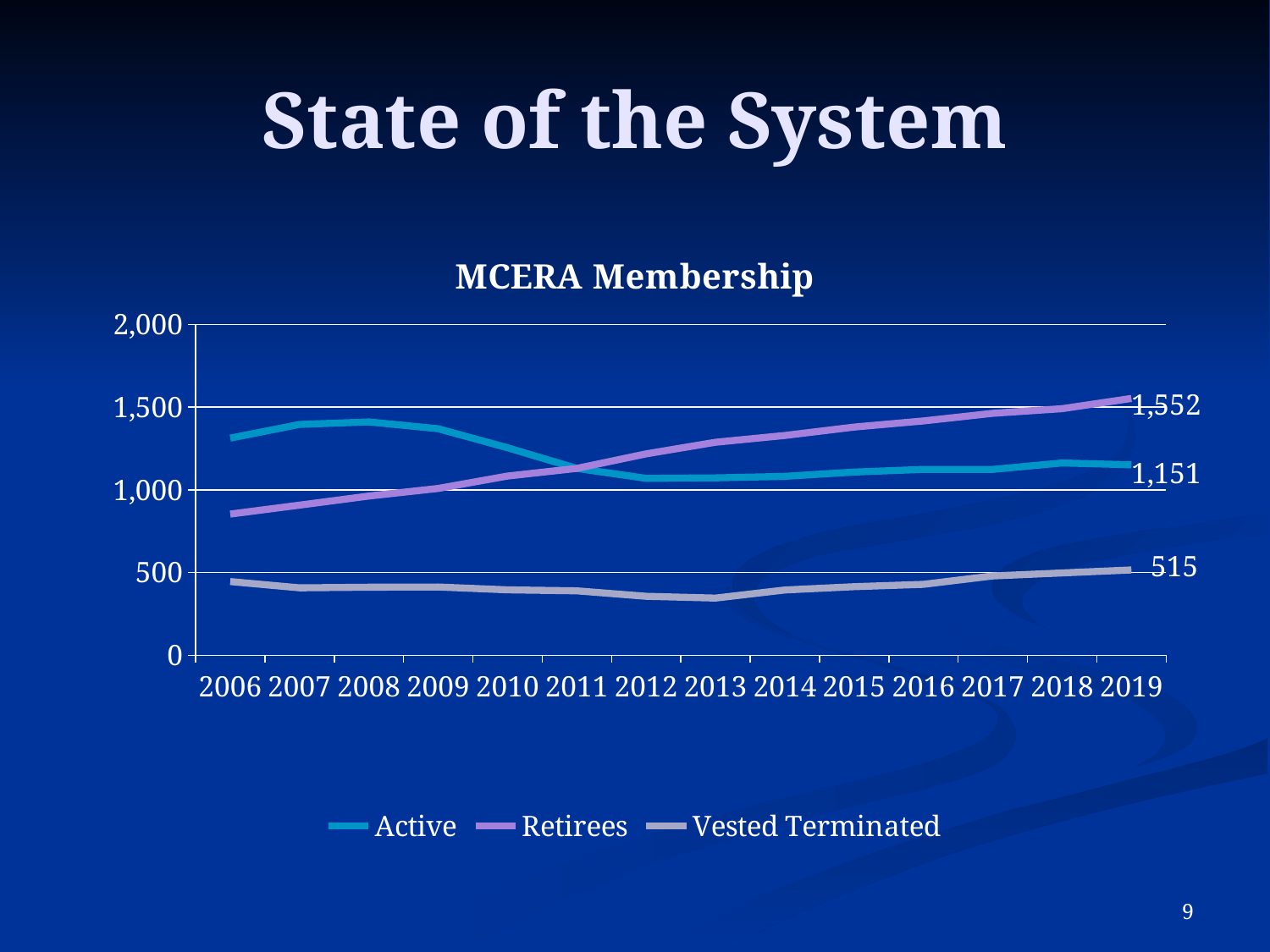
What is the value for Retirees in 2019? 1,552 Does the Retirees line rise or fall from 2006 to 2019? Rises How many years are shown on the x axis of the MCERA Membership chart? 14 How many series does the legend of the MCERA Membership chart list? 3 What is the value for Active in 2019? 1,151 What is the title of the chart? MCERA Membership Which series has the highest value in 2019? Retirees What kind of chart is shown on the slide? Line chart What is the value for Vested Terminated in 2019? 515 Which series has the lowest value in 2019? Vested Terminated Is the value for Retirees in 2006 greater or less than 1,000? less What is the difference between the Retirees and Active values in 2019? 401